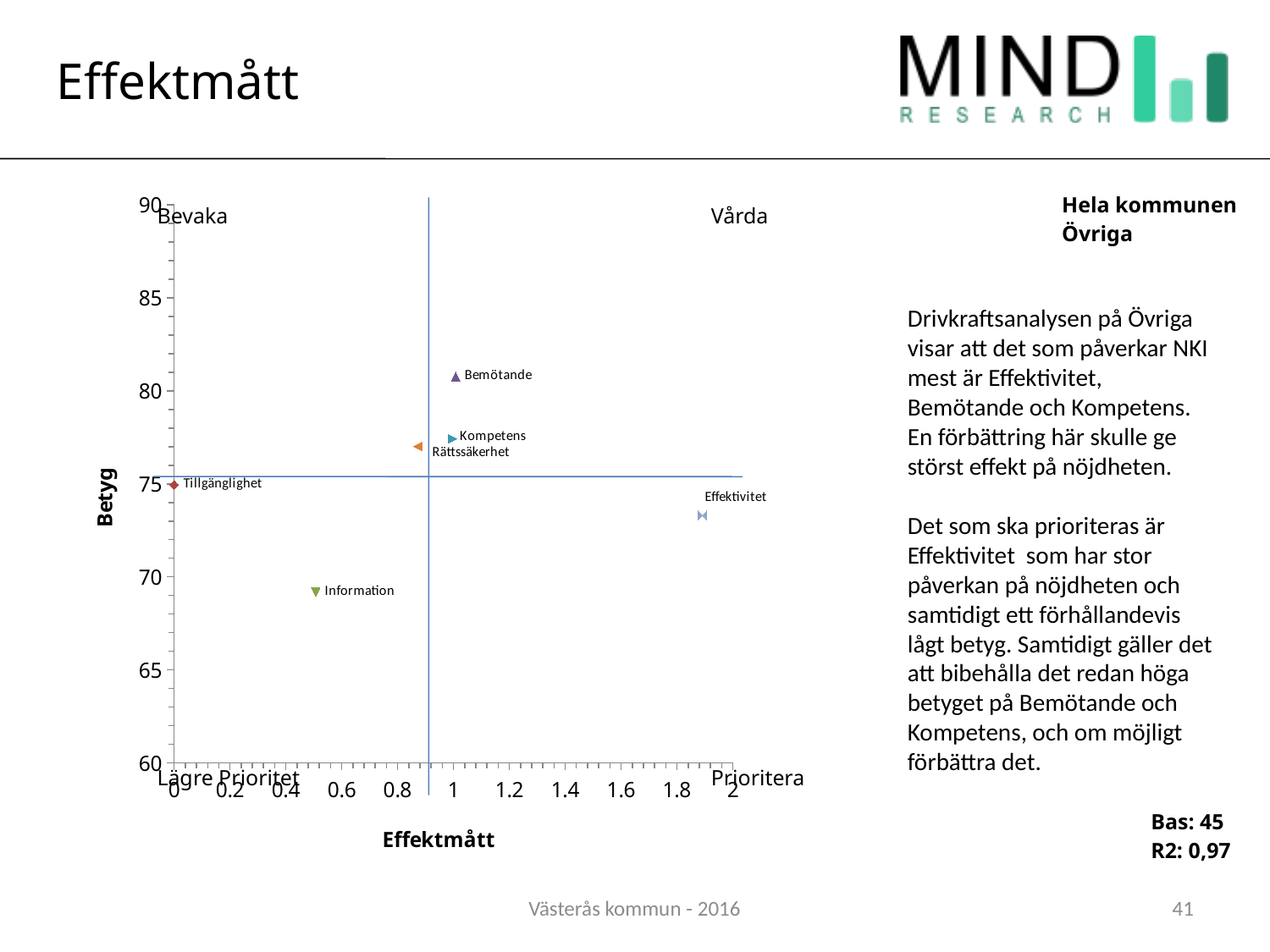
How many labelled data points are plotted in the chart? 6 Which point has the lowest Effektmått value? Tillgänglighet Is the Betyg value for Kompetens greater or less than 75? greater Which point has the highest Betyg value? Bemötande Is the Betyg value for Information greater or less than 75? less What kind of chart is shown on the slide? scatter chart Which has the higher Effektmått value, Effektivitet or Information? Effektivitet Which point has the lowest Betyg value? Information What is the title of the vertical axis of the chart? Betyg Which has the higher Betyg value, Bemötande or Information? Bemötande Is the Effektmått value for Effektivitet greater or less than 1.8? greater Which point has the highest Effektmått value? Effektivitet